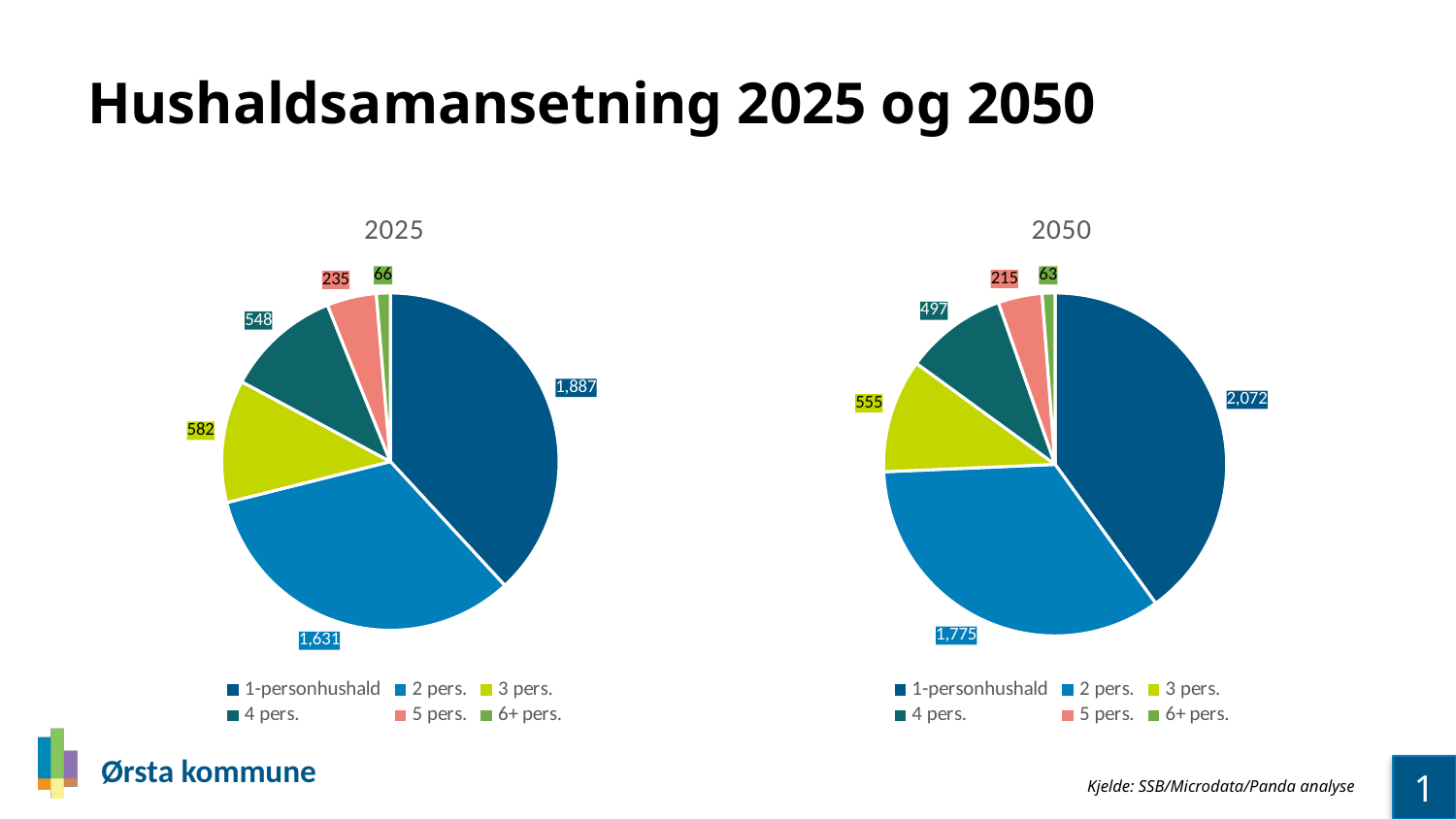
In the 2050 pie chart, which category has the largest slice? 1-personhushald Which is larger: the 2 pers. value in the 2025 chart or the 2 pers. value in the 2050 chart? 2050 How many categories does the 2025 pie chart show? 6 In the 2050 pie chart, what is the value for 4 pers.? 497 In the 2025 pie chart, what is the value for 1-personhushald? 1,887 In the 2025 pie chart, what is the difference between the 3 pers. and 4 pers. values? 34 In the 2025 pie chart, what is the value for 5 pers.? 235 What type of chart is used for the 2050 data? Pie chart What is the title of the slide? Hushaldsamansetning 2025 og 2050 What is the difference between the 1-personhushald value in the 2050 chart and the 1-personhushald value in the 2025 chart? 185 In the 2050 pie chart, what is the value for 2 pers.? 1,775 In the 2025 pie chart, which category has the smallest slice? 6+ pers.